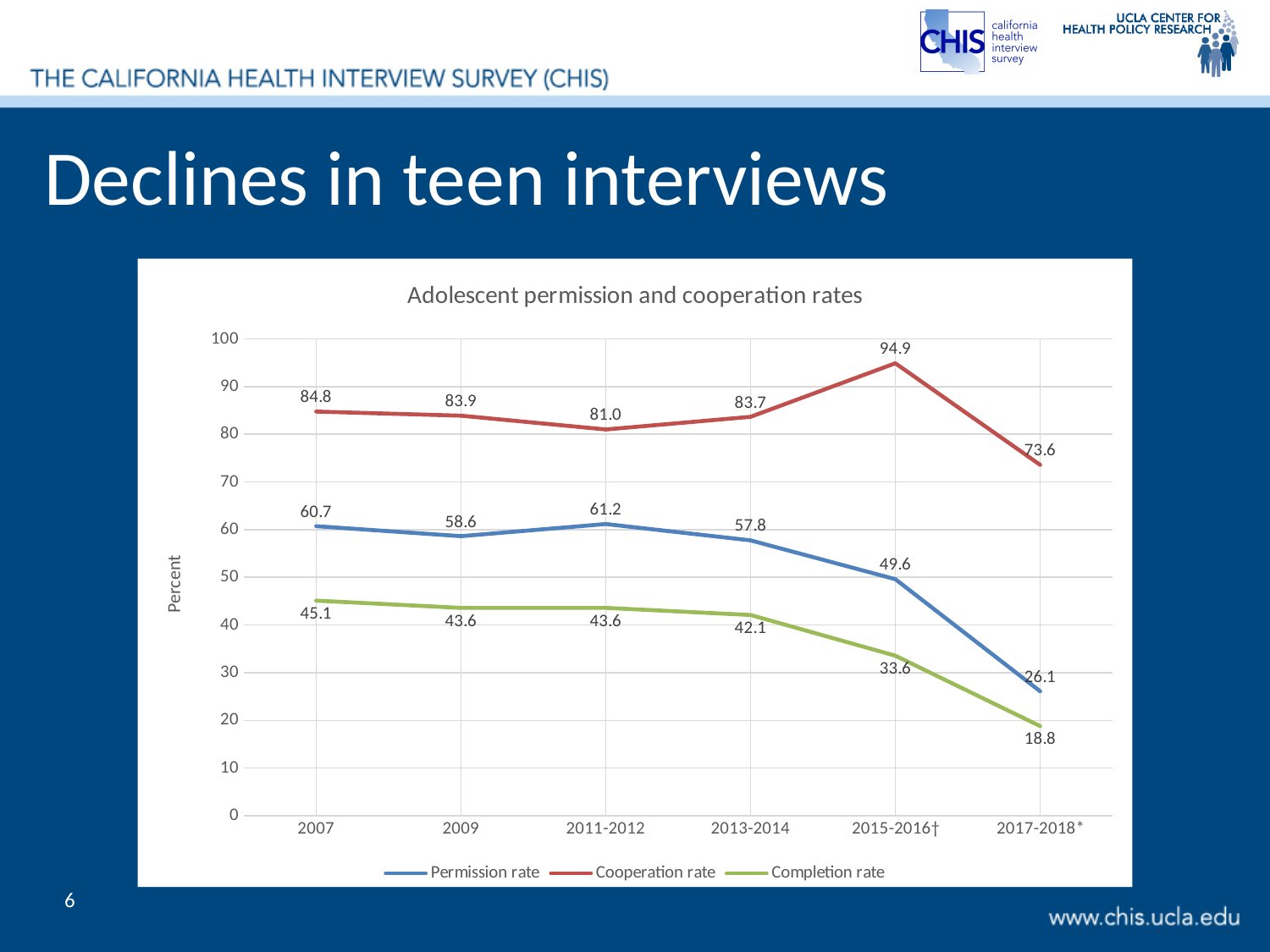
In which period is the Cooperation rate highest? 2015-2016† Is the Completion rate for 2015-2016† greater or less than 40? less How many time periods are shown on the x axis? 6 In which period is the Permission rate lowest? 2017-2018* What is the title of the chart? Adolescent permission and cooperation rates What is the Permission rate for 2007? 60.7 What is the Completion rate for 2017-2018*? 18.8 What kind of chart is shown? line chart What is the Cooperation rate for 2015-2016†? 94.9 What is the difference between the Cooperation rate in 2015-2016† and in 2017-2018*? 21.3 Which is larger: the Permission rate in 2011-2012 or the Permission rate in 2013-2014? 2011-2012 How many series does the legend list? 3